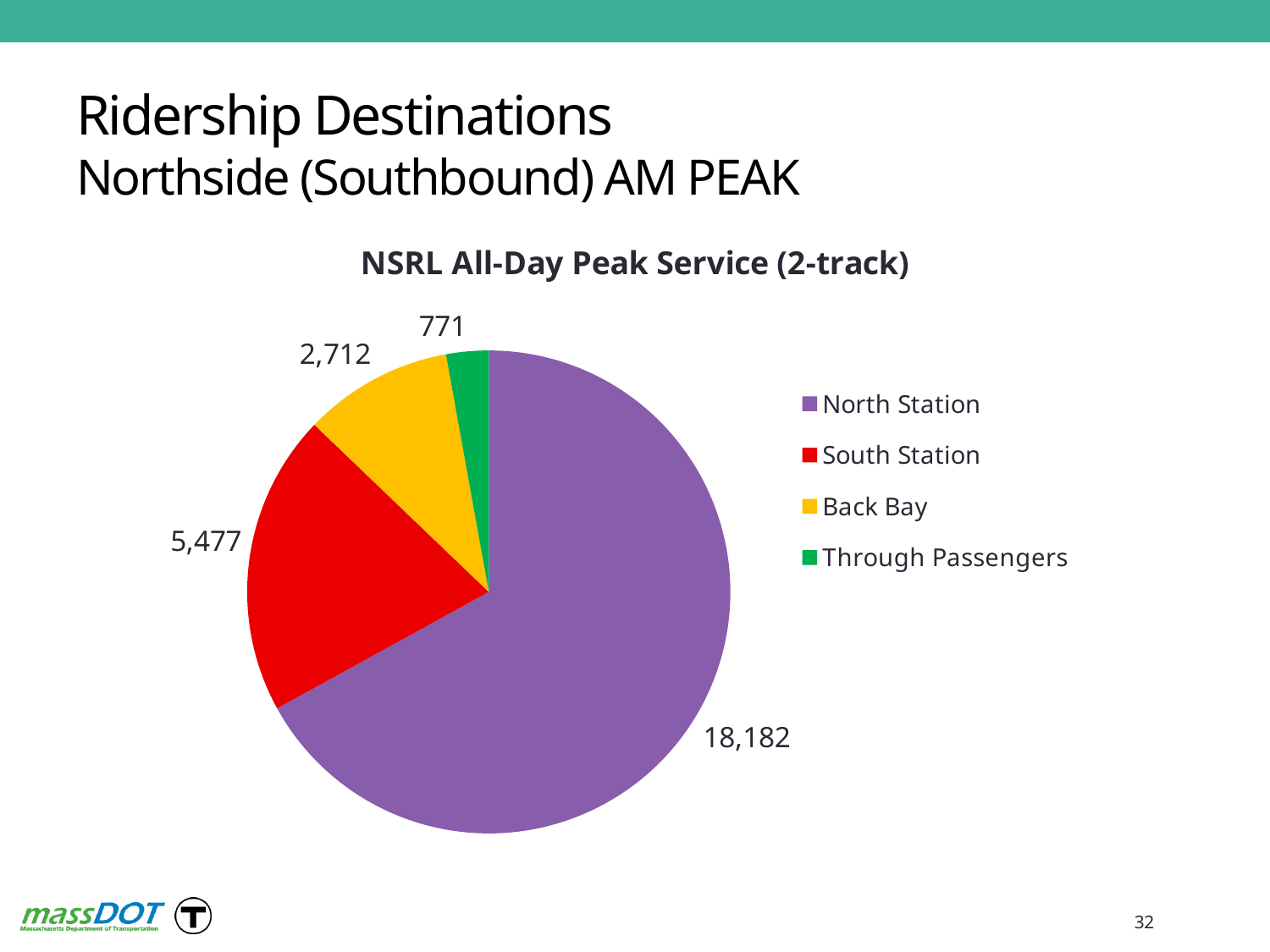
What is the difference between the Back Bay and Through Passengers values? 1,941 How many destination categories are shown in the pie chart? 4 What is the difference between the North Station and South Station values? 12,705 What kind of chart is shown on the slide? Pie chart Which destination has the largest slice of the pie? North Station What is the value for North Station? 18,182 What is the value for Through Passengers? 771 What is the value for South Station? 5,477 Which is larger, the value for South Station or the value for Back Bay? South Station What is the value for Back Bay? 2,712 Which destination has the smallest slice of the pie? Through Passengers What is the title of the chart? NSRL All-Day Peak Service (2-track)